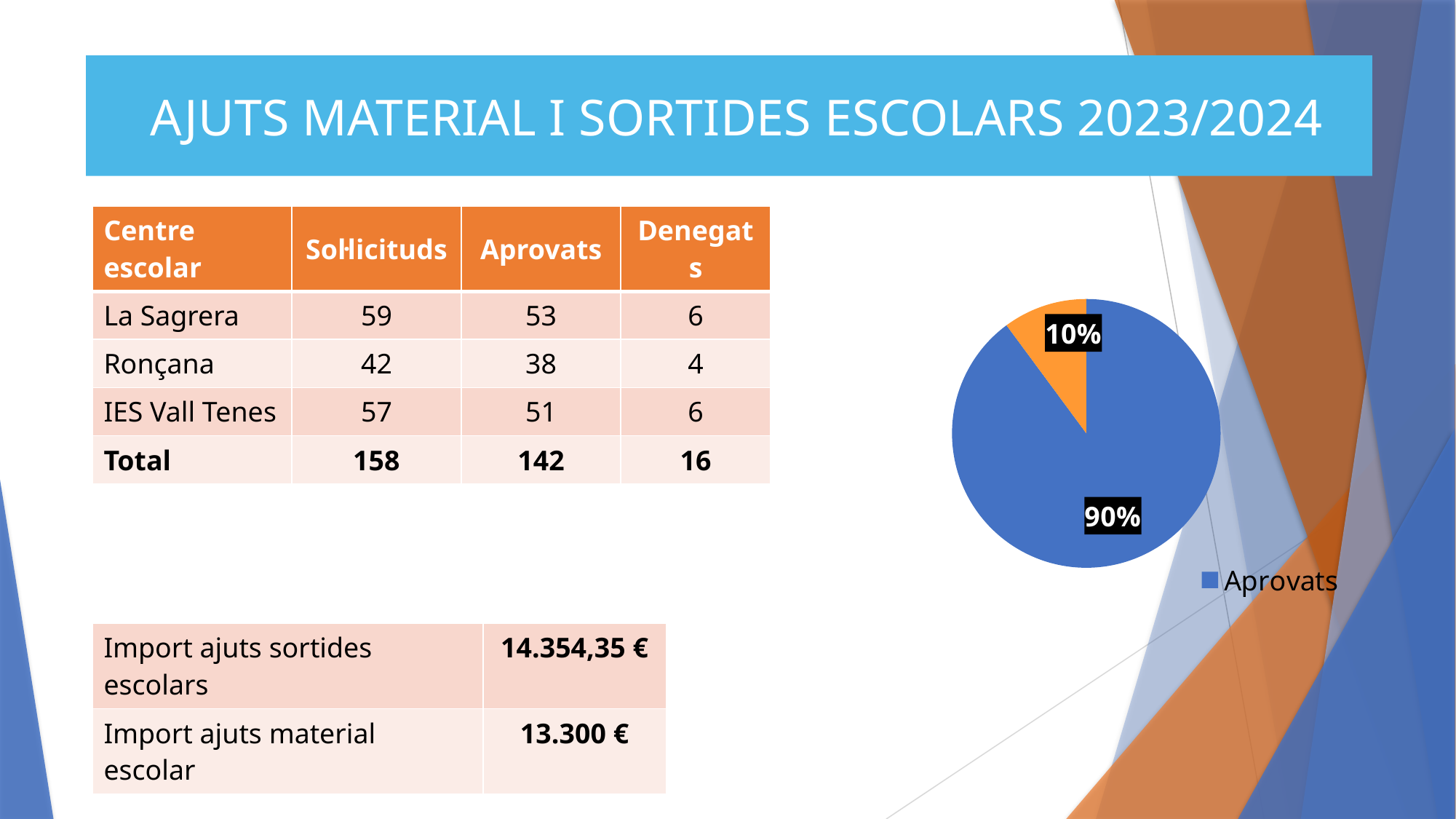
Is the share of the Aprovats slice greater or less than 50%? greater Which slice of the pie chart is the largest? Aprovats What colour is the Aprovats slice in the pie chart? blue What kind of chart is shown on the right of the slide? pie chart What is the difference in percentage points between the two slices of the pie chart? 80 How many slices does the pie chart have? 2 What label appears in the legend of the pie chart? Aprovats In the pie chart, what percentage is labelled on the smaller orange slice? 10% In the pie chart, what share is labelled on the Aprovats slice? 90% How many entries does the pie chart's legend list? 1 What do the two labelled slices of the pie chart add up to? 100% Is the Aprovats slice of the pie chart larger or smaller than the orange slice? larger